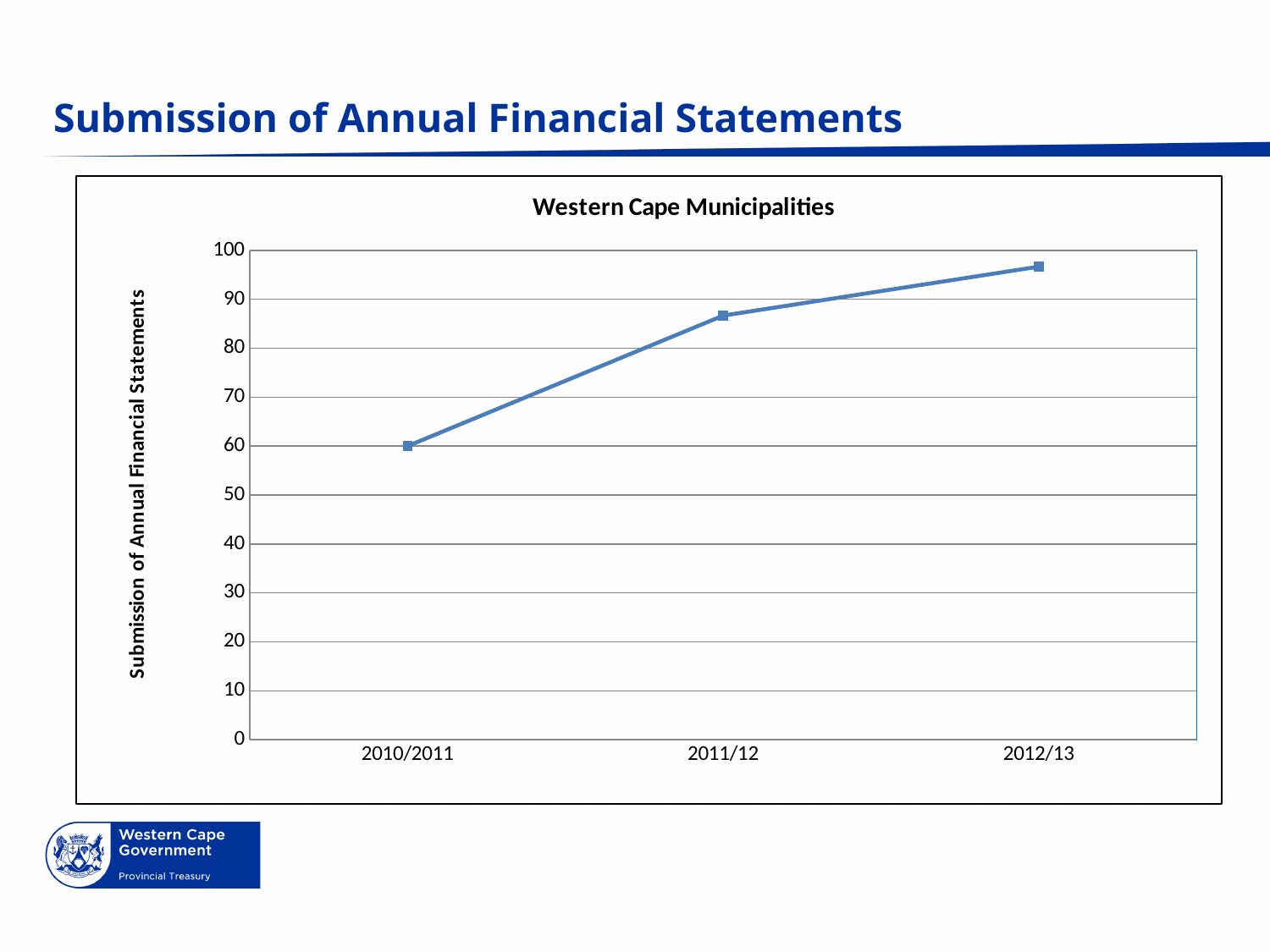
What is the value for 2010/2011? 60 Which financial year has the lowest value? 2010/2011 Which is larger, the value for 2011/12 or the value for 2012/13? 2012/13 Is the value for 2010/2011 greater or less than 70? less What kind of chart is shown on the slide? Line chart Is the value for 2012/13 greater or less than 90? greater How many financial years are plotted on the x axis? 3 Is the value for 2011/12 greater or less than 80? greater Do the values rise or fall from 2010/2011 to 2012/13? Rise What is the title of the chart? Western Cape Municipalities What is the label on the vertical axis of the chart? Submission of Annual Financial Statements Which financial year has the highest value? 2012/13